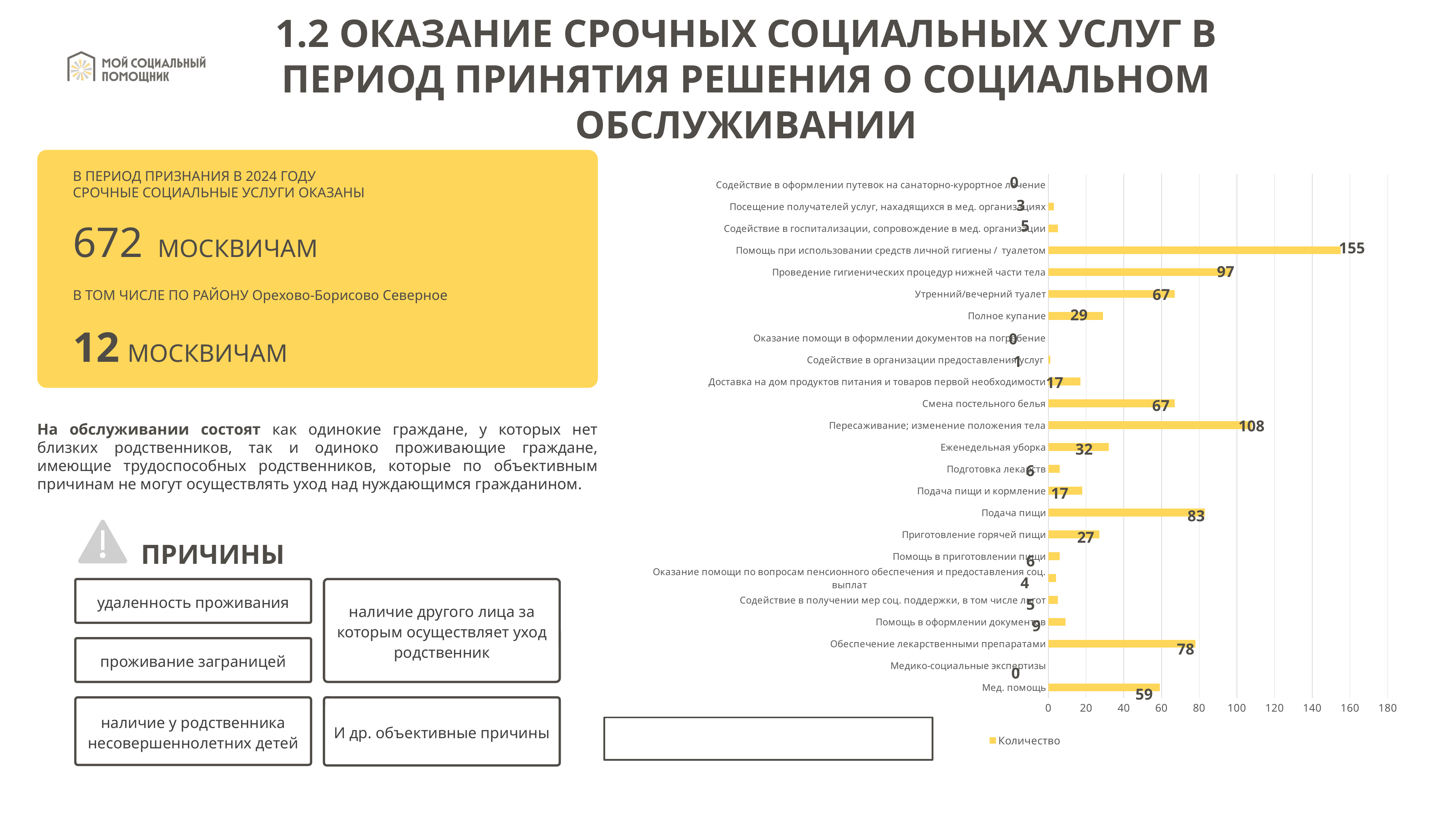
How many series does the chart legend list? 1 What is the value for "Мед. помощь"? 59 What is the name of the series shown in the chart legend? Количество What is the value for "Пересаживание; изменение положения тела"? 108 How many categories are plotted in the chart? 24 What is the value for "Обеспечение лекарственными препаратами"? 78 Which category has the highest value in the chart? Помощь при использовании средств личной гигиены / туалетом What is the difference between the values for "Проведение гигиенических процедур нижней части тела" and "Полное купание"? 68 What type of chart is shown on the right side of the slide? Bar chart What is the value for "Помощь при использовании средств личной гигиены / туалетом"? 155 Which is larger: the value for "Подача пищи" or the value for "Обеспечение лекарственными препаратами"? Подача пищи Is the value for "Проведение гигиенических процедур нижней части тела" greater or less than 80? greater